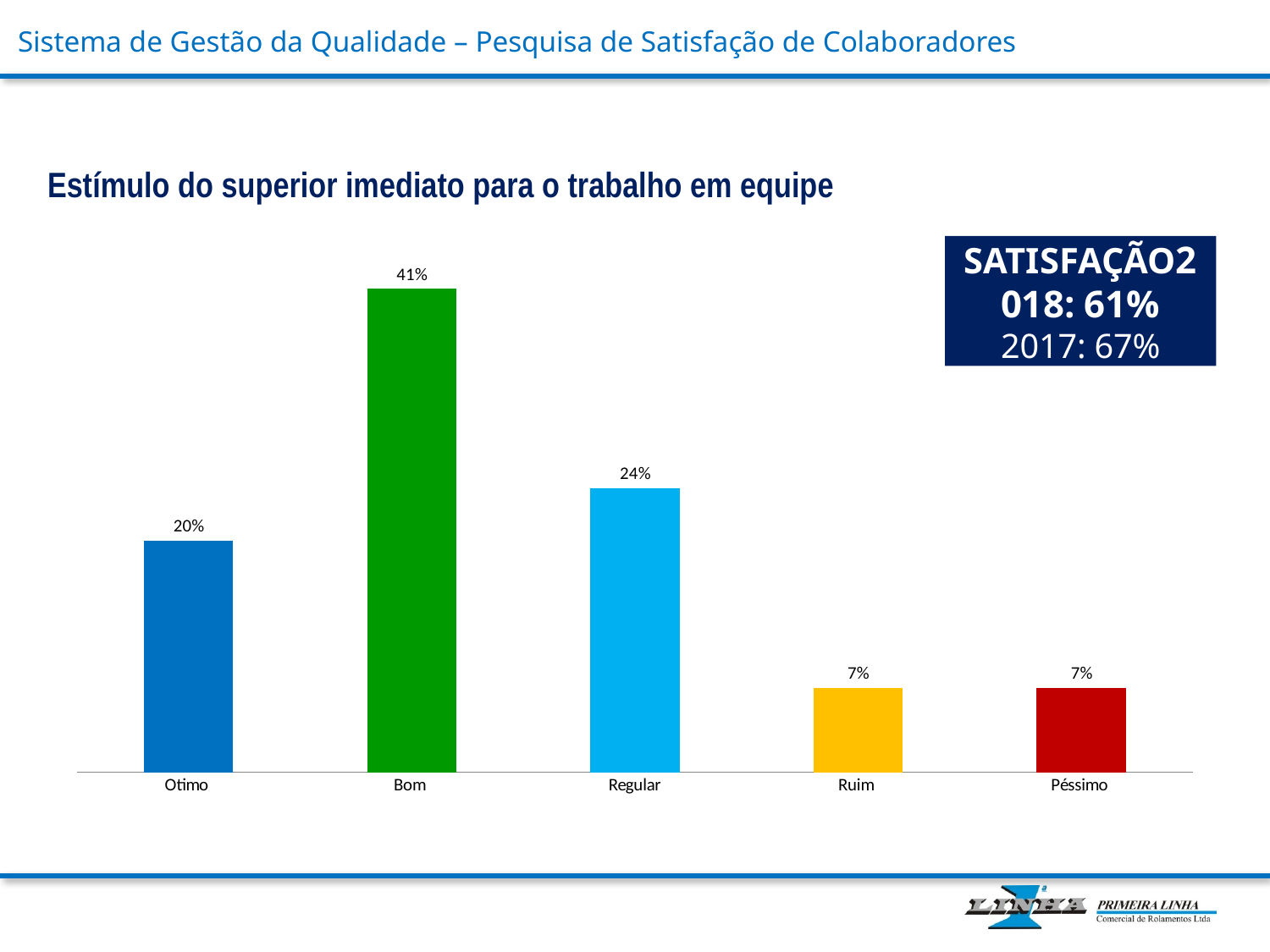
Which is larger, the value for Bom or the value for Otimo? Bom What is the value for Ruim? 7% What kind of chart is shown on the slide? Bar chart Which is larger, the value for Otimo or the value for Regular? Regular How many categories are shown on the x axis? 5 What is the difference between the values for Bom and Regular? 17% What is the value for Otimo? 20% Which category has the highest value? Bom What is the value for Regular? 24% What is the difference between the values for Regular and Otimo? 4% What is the value for Bom? 41% What is the title of the chart? Estímulo do superior imediato para o trabalho em equipe